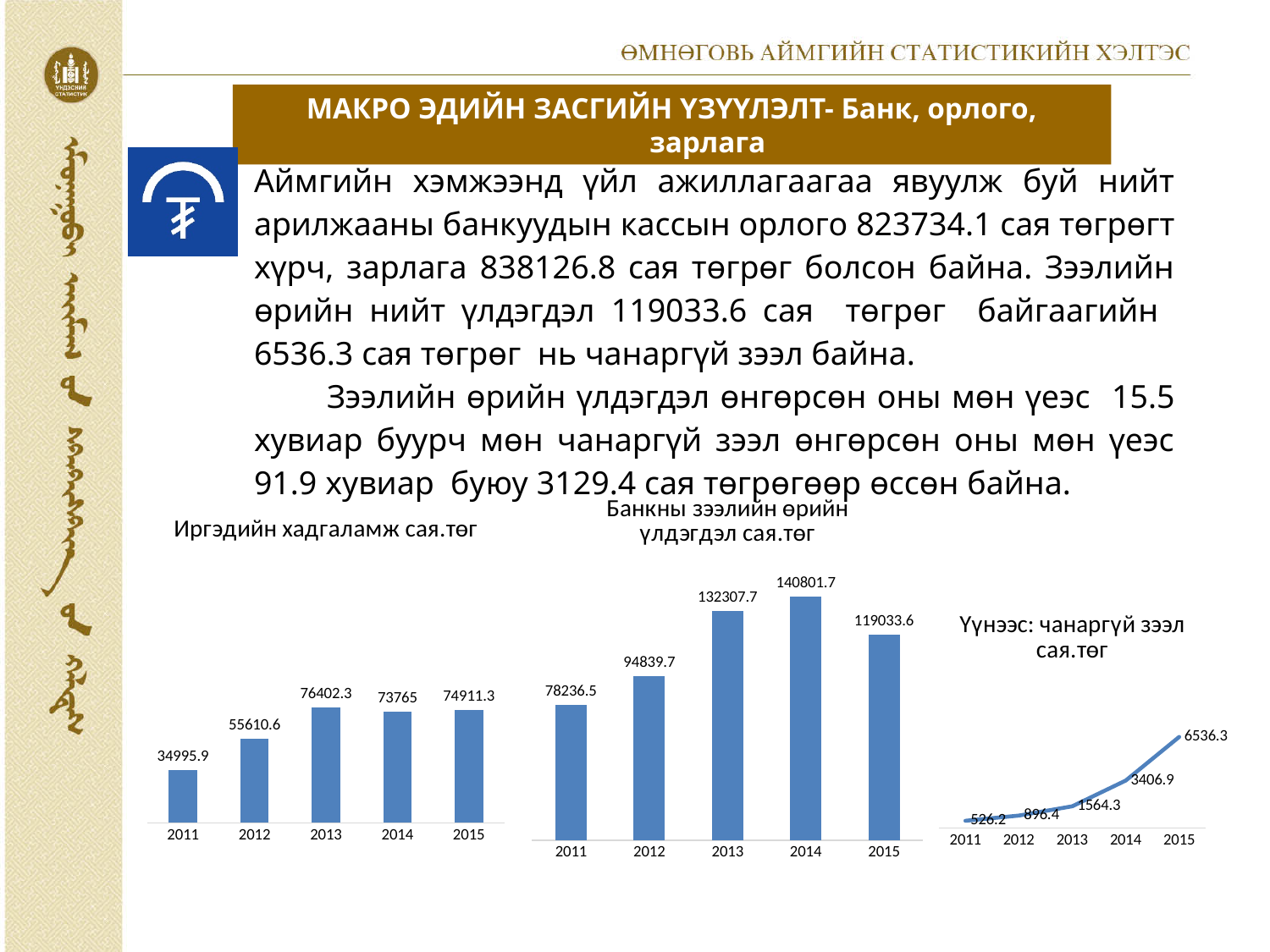
In the chart titled "Иргэдийн хадгаламж сая.төг", how many years are shown on the x axis? 5 In the chart titled "Иргэдийн хадгаламж сая.төг", which year has the highest value? 2013 What kind of chart is the chart titled "Үүнээс: чанаргүй зээл сая.төг"? line chart In the chart titled "Банкны зээлийн өрийн үлдэгдэл сая.төг", what is the value for 2014? 140801.7 In the chart titled "Үүнээс: чанаргүй зээл сая.төг", do the values rise or fall from 2011 to 2015? rise In the chart titled "Иргэдийн хадгаламж сая.төг", what is the value for 2011? 34995.9 What kind of chart is the chart titled "Банкны зээлийн өрийн үлдэгдэл сая.төг"? bar chart In the chart titled "Иргэдийн хадгаламж сая.төг", what is the difference between the values for 2012 and 2011? 20614.7 In the chart titled "Банкны зээлийн өрийн үлдэгдэл сая.төг", what is the difference between the values for 2014 and 2015? 21768.1 In the chart titled "Банкны зээлийн өрийн үлдэгдэл сая.төг", which is larger, the value for 2013 or the value for 2015? 2013 In the chart titled "Банкны зээлийн өрийн үлдэгдэл сая.төг", which year has the lowest value? 2011 In the chart titled "Үүнээс: чанаргүй зээл сая.төг", what is the value for 2015? 6536.3